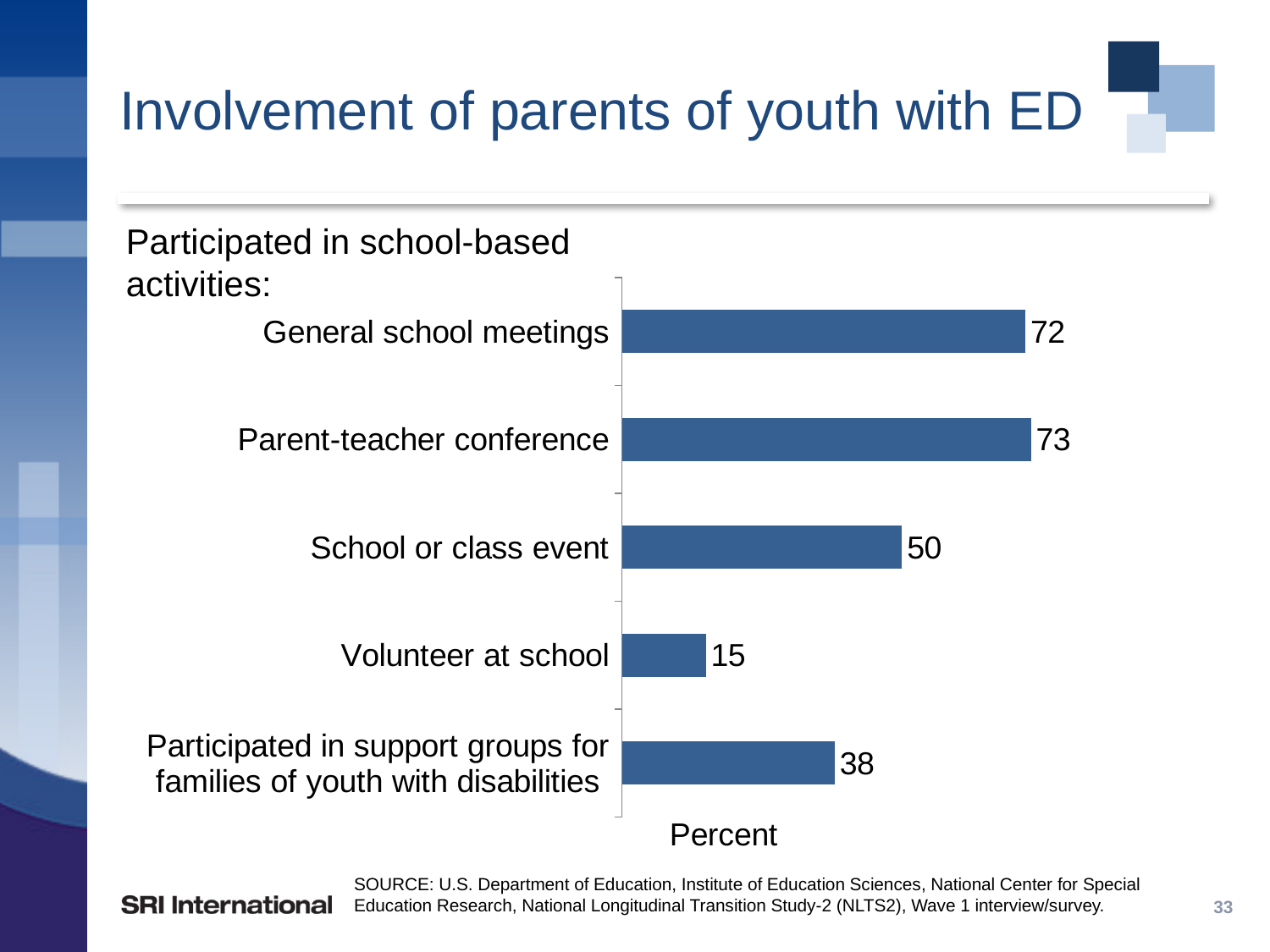
What is the value shown for Parent-teacher conference? 73 What percentage of parents volunteered at school? 15 What is the title of the slide? Involvement of parents of youth with ED What percentage of parents of youth with ED attended general school meetings? 72 Which is larger: the value for School or class event or the value for Participated in support groups for families of youth with disabilities? School or class event What kind of chart is shown on the slide? Bar chart What is the difference between the values for School or class event and Volunteer at school? 35 What is the difference between the values for General school meetings and Participated in support groups for families of youth with disabilities? 34 How many categories are shown in the chart? 5 What is the label on the horizontal axis of the chart? Percent What is the value for participating in support groups for families of youth with disabilities? 38 Which category has the lowest value? Volunteer at school